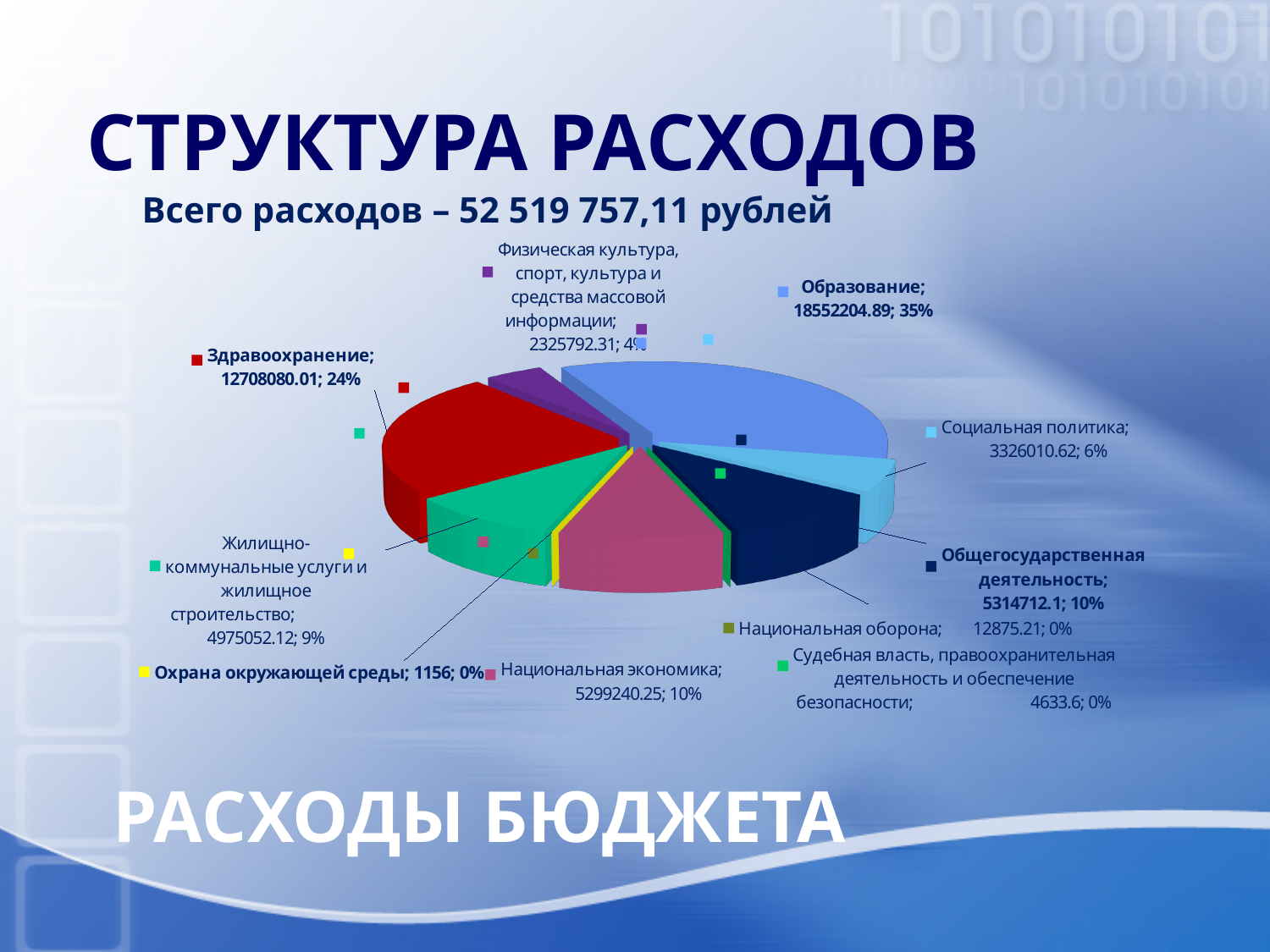
Which category has the smallest value in the pie chart? Охрана окружающей среды What kind of chart is shown on the slide? Pie chart What share of expenses does Жилищно-коммунальные услуги и жилищное строительство account for? 9% Which category has the largest share of expenses in the pie chart? Образование How many categories does the pie chart show? 10 What is the value shown for Здравоохранение? 12708080.01 Which is larger, the value for Общегосударственная деятельность or for Национальная экономика? Общегосударственная деятельность What is the value shown for Социальная политика? 3326010.62 What is the value shown for Национальная оборона? 12875.21 What is the difference between the values for Образование and Здравоохранение? 5844124.88 What share of expenses does Образование account for? 35% What total expenses figure is stated above the chart? 52 519 757,11 рублей